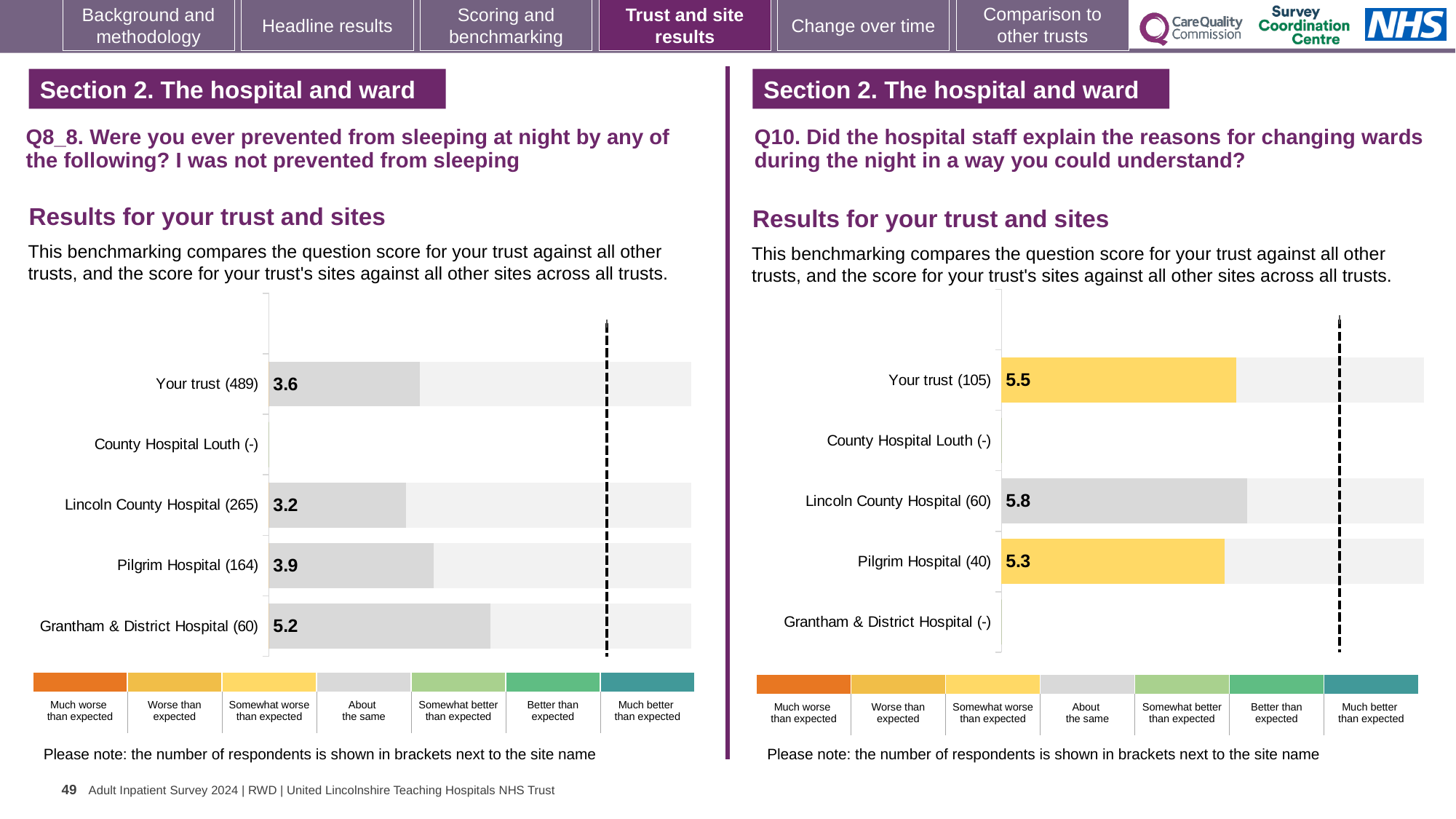
In the Q10 chart on the right, what is the difference between the scores for Lincoln County Hospital and Your trust? 0.3 In the Q10 chart on the right, what is the score for Lincoln County Hospital? 5.8 In the Q8_8 chart on the left, which site has the highest score? Grantham & District Hospital In the Q10 chart on the right, how many respondents are shown in brackets for Your trust? 105 In the Q10 chart on the right, is the score for Your trust larger or smaller than the score for Pilgrim Hospital? larger In the Q8_8 chart on the left, what is the score for Your trust? 3.6 In the Q10 chart on the right, what is the score for Pilgrim Hospital? 5.3 In the Q10 chart on the right, which site has the highest score? Lincoln County Hospital In the Q8_8 chart on the left, what is the difference between the scores for Pilgrim Hospital and Lincoln County Hospital? 0.7 In the Q8_8 chart on the left, what is the score for Grantham & District Hospital? 5.2 In the Q8_8 chart on the left, which site has the lowest score? Lincoln County Hospital What kind of chart is used in the Q8_8 chart on the left? Bar chart